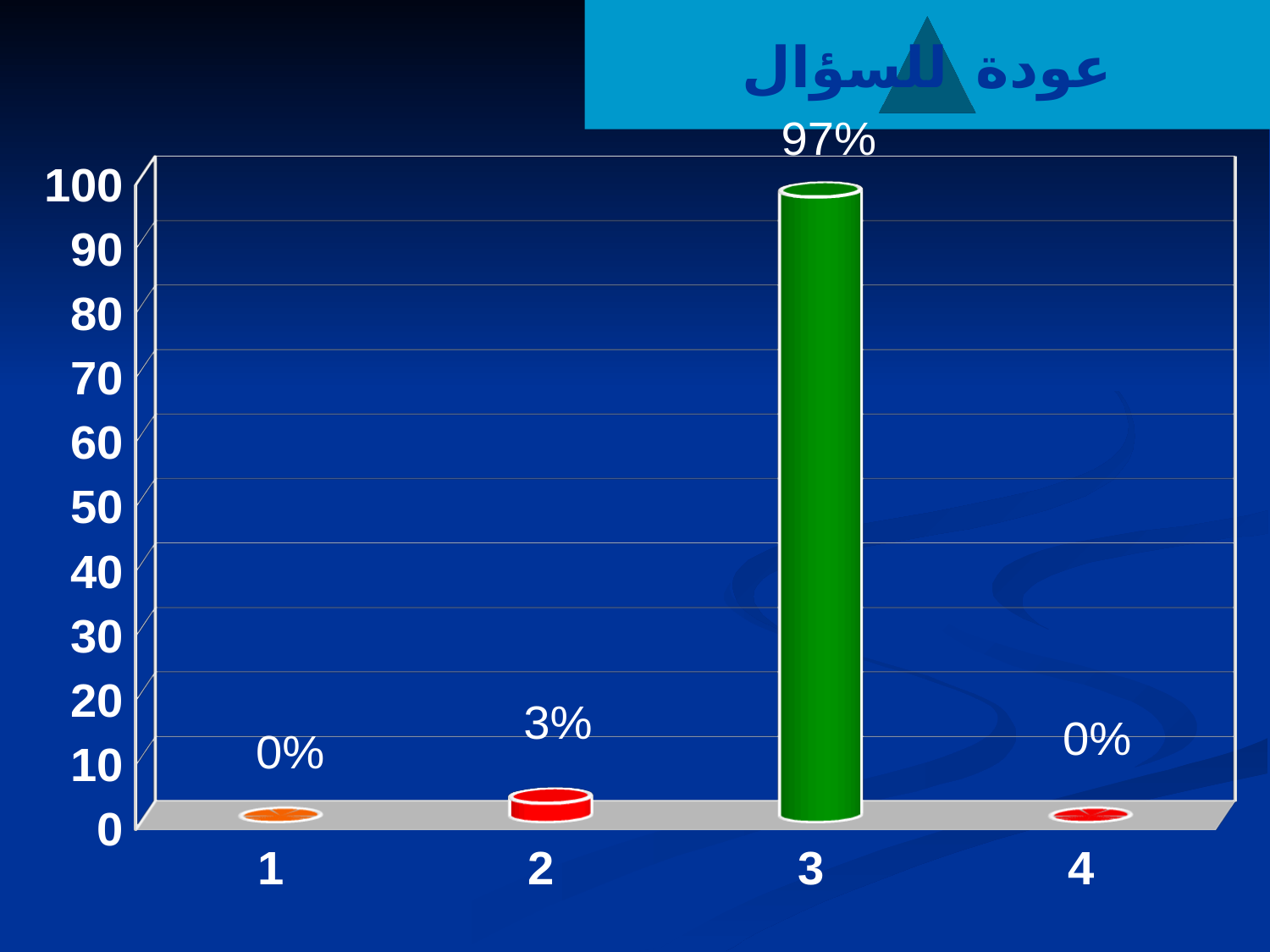
Which category has the highest value? 3 What is the value for category 2? 3% What is the difference between the values for category 3 and category 2? 94% Is the value for category 2 greater or less than 10? less How many categories are shown on the x axis? 4 What colour is the bar for category 3? green Which is larger, the value for category 2 or the value for category 3? the value for category 3 What is the value for category 1? 0% Is the value for category 3 greater or less than 90? greater What is the value for category 3? 97% What kind of chart is shown on the slide? bar chart What is the value for category 4? 0%